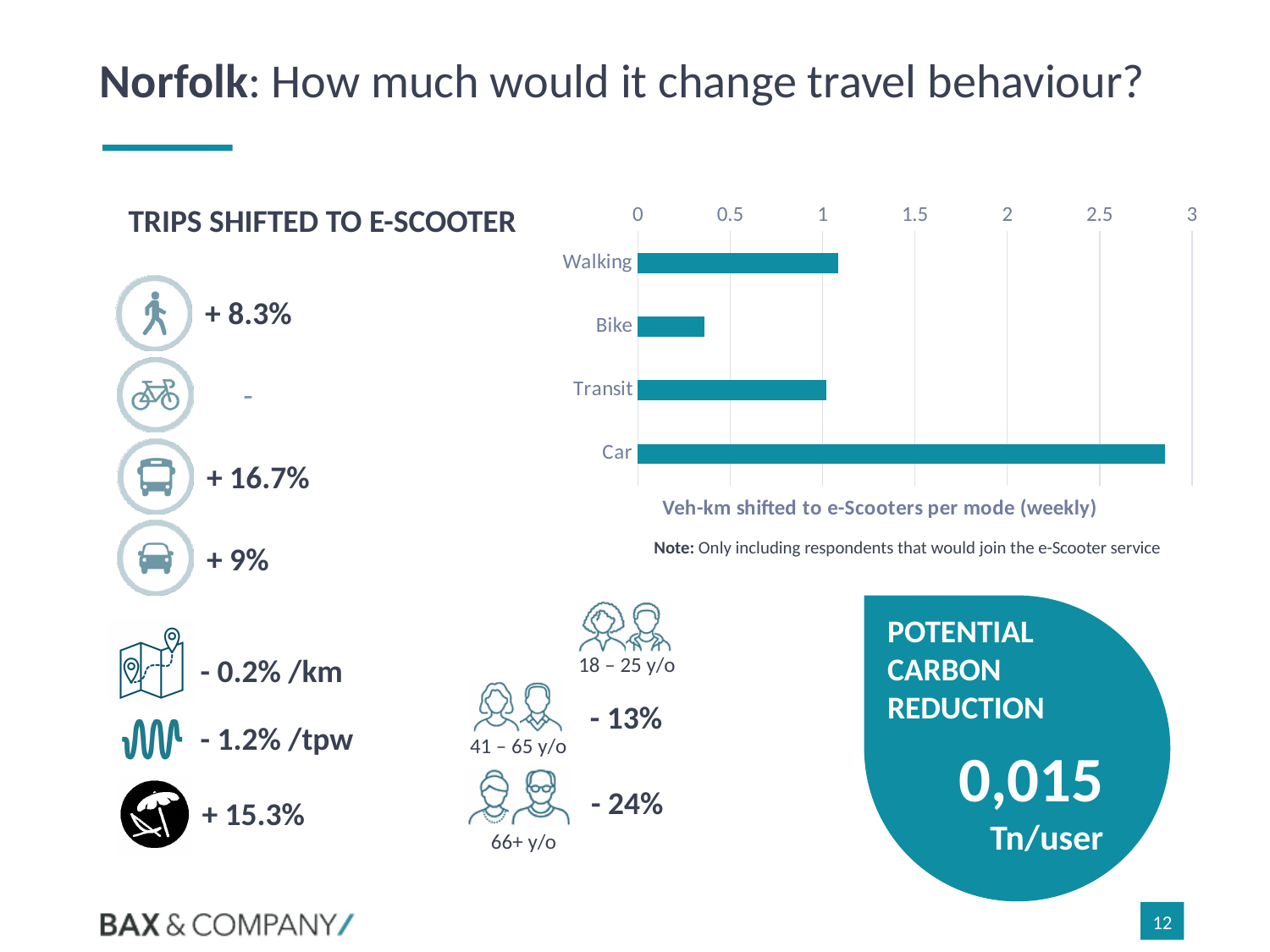
What kind of chart is shown on the slide? bar chart Is the value for Bike greater or less than 0.5? less Is the value for Transit greater or less than 0.5? greater Which mode has the highest value in the bar chart? Car How many modes (categories) are plotted in the bar chart? 4 What is the maximum value shown on the bar chart's axis? 3 Is the value for Walking greater or less than 1.5? less Which mode has the lowest value in the bar chart? Bike Which is larger in the bar chart, the value for Car or the value for Walking? Car Which is larger in the bar chart, the value for Bike or the value for Transit? Transit What is the title of the bar chart? Veh-km shifted to e-Scooters per mode (weekly)